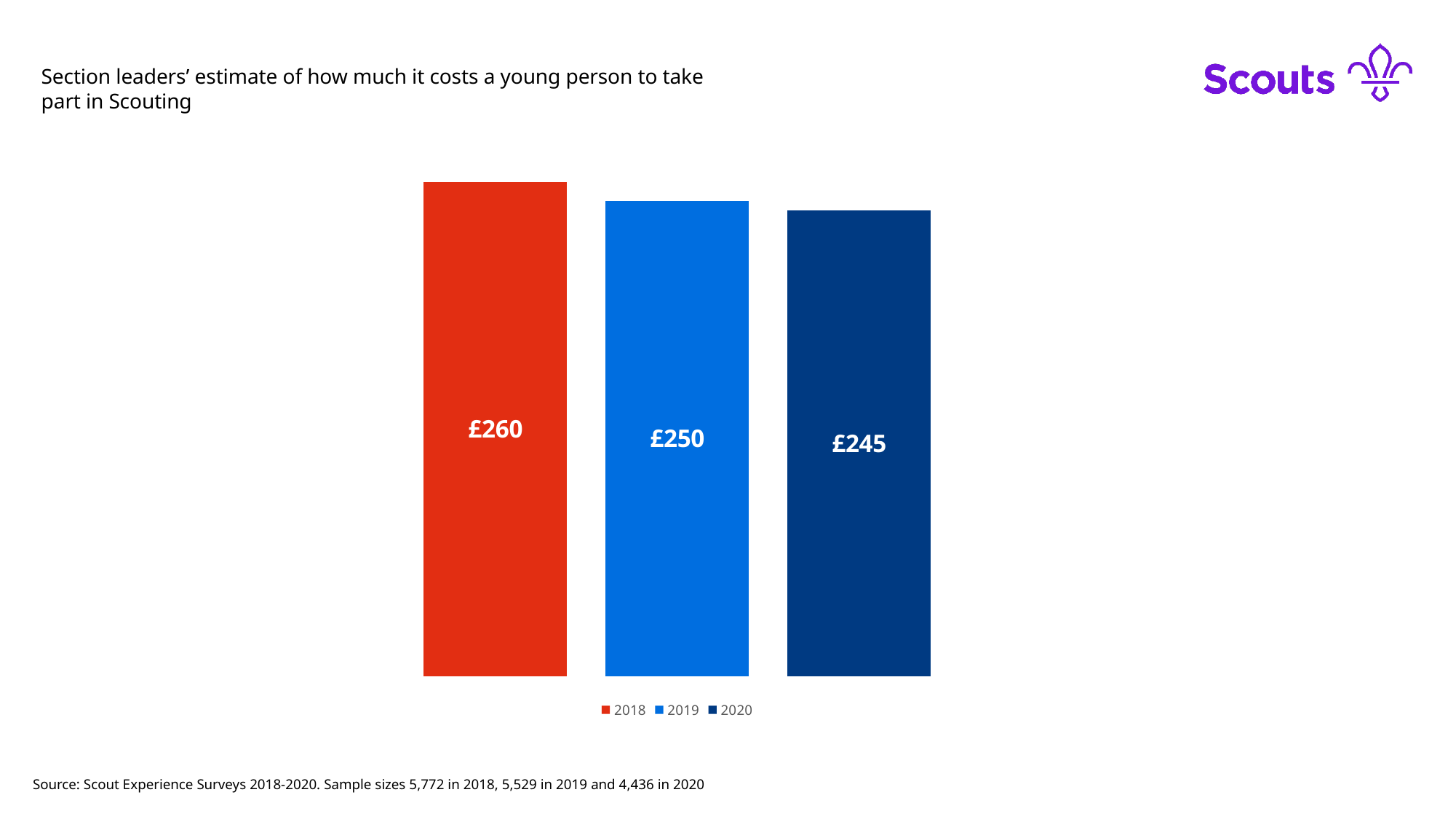
Do the estimated costs rise or fall from 2018 to 2020? Fall What kind of chart is shown on the slide? Bar chart How many years are shown in the chart? 3 What is the difference between the estimated cost in 2019 and in 2020? £5 How many entries does the legend list? 3 Which is larger, the estimated cost for 2018 or for 2019? 2018 What is the difference between the estimated cost in 2018 and in 2020? £15 What is the estimated cost shown for 2020? £245 Which year has the highest estimated cost? 2018 Which year has the lowest estimated cost? 2020 What is the estimated cost shown for 2019? £250 What is the section leaders' estimated cost for a young person to take part in Scouting in 2018? £260